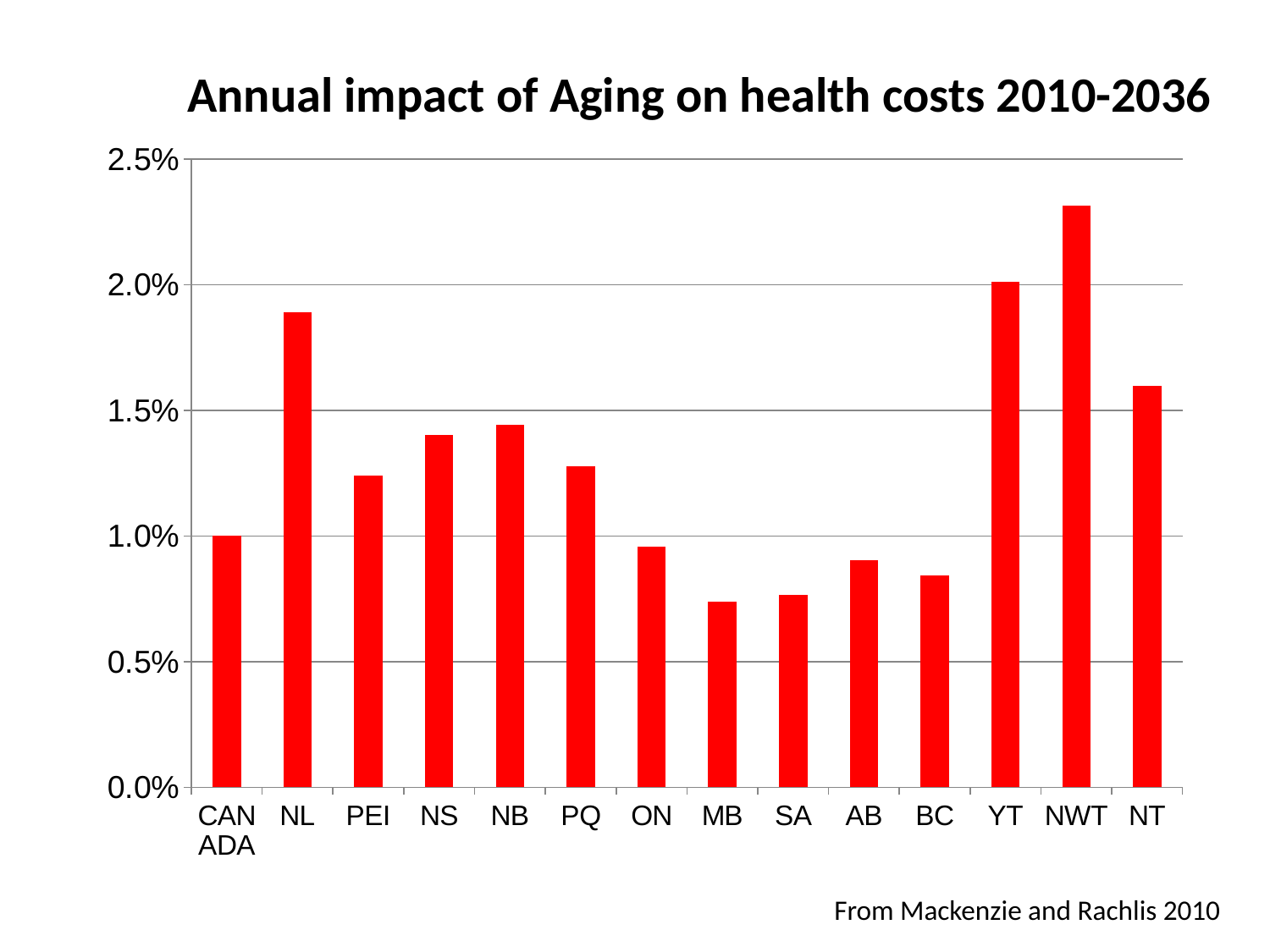
How many categories are shown on the x axis of the chart? 14 Is the value for NWT greater or less than 2.0%? greater Is the value for NL greater or less than 1.5%? greater Which is larger, the value for NS or the value for PQ? NS According to the note on the slide, what is the source of the chart data? Mackenzie and Rachlis 2010 What kind of chart is shown on the slide? bar chart What is the value for CANADA? 1.0% Is the value for PEI greater or less than 1.5%? less What is the title of the chart? Annual impact of Aging on health costs 2010-2036 Which is larger, the value for NL or the value for NT? NL Which category has the highest value in the chart? NWT